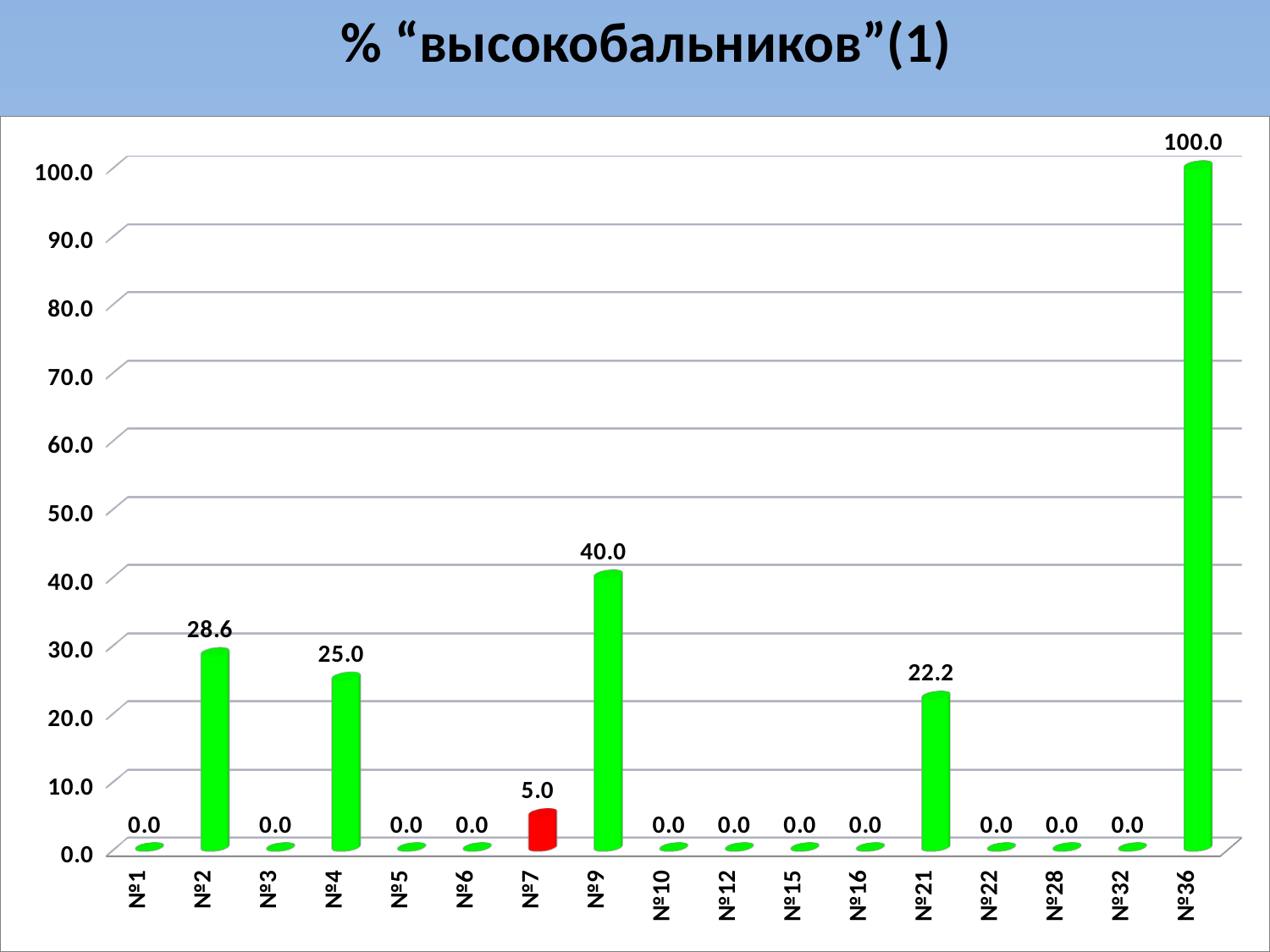
Which category's bar is coloured red instead of green? №7 What is the value for №21? 22.2 What kind of chart is shown on the slide? bar chart What is the value for №2? 28.6 What is the difference between the values for №36 and №9? 60.0 Which is larger, the value for №4 or the value for №21? №4 How many categories are shown on the x axis? 17 What is the difference between the values for №2 and №4? 3.6 What is the value for №9? 40.0 Is the value for №9 greater or less than 30.0? greater Which category has the highest value? №36 What is the value for №7? 5.0